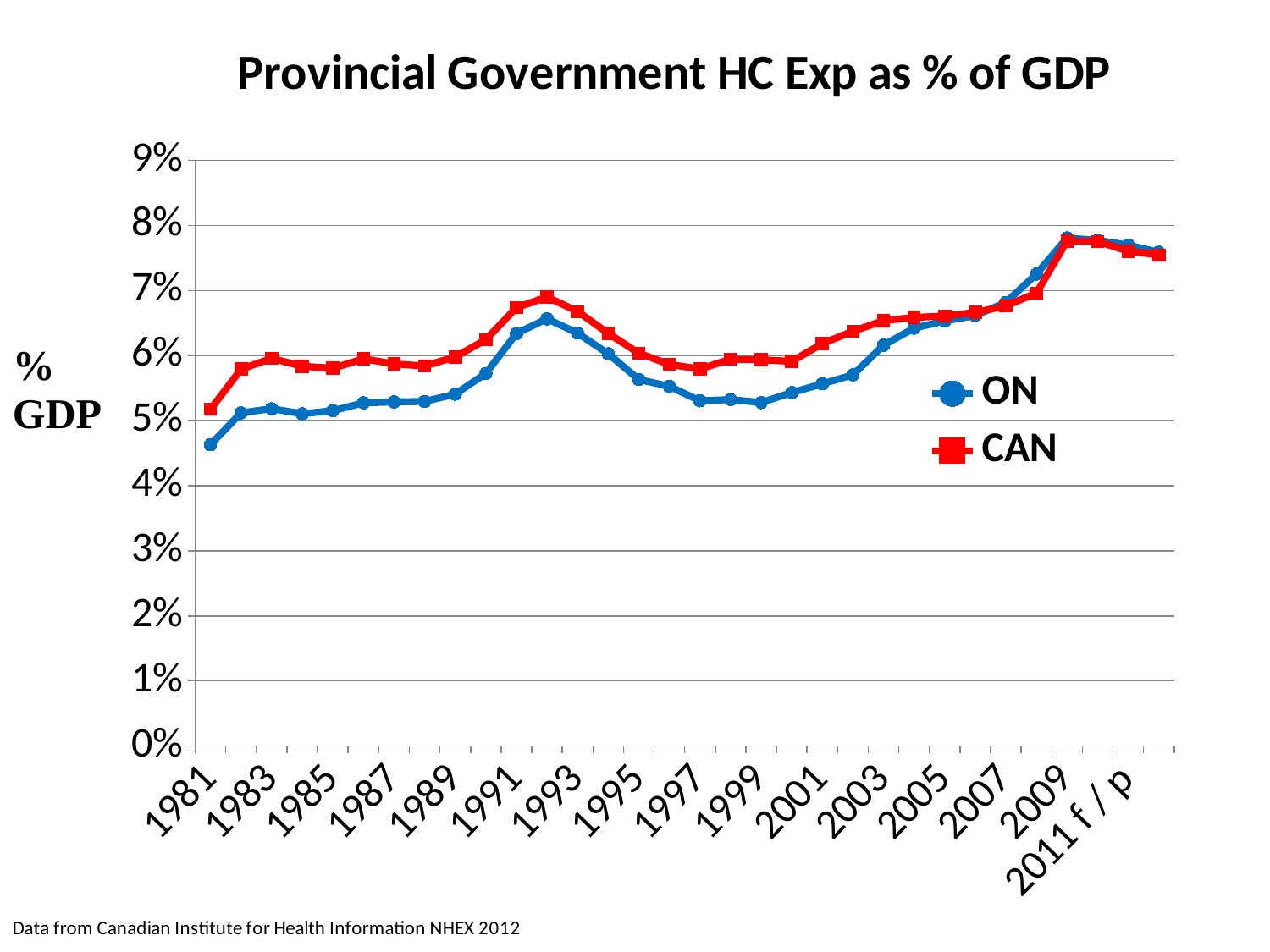
Does the ON series rise or fall from 1993 to 1997? fall What is the title of the chart? Provincial Government HC Exp as % of GDP In which year is the CAN series at its lowest? 1981 Which series has the larger value in 1995, ON or CAN? CAN Is the value for CAN in 1993 greater or less than 7%? less Is the value for CAN in 1981 greater or less than 5%? greater Is the value for ON in 1981 greater or less than 5%? less Which colour is used for the CAN series? red Which series has the larger value in 1999, ON or CAN? CAN What kind of chart is shown on the slide? line chart How many series does the legend list? 2